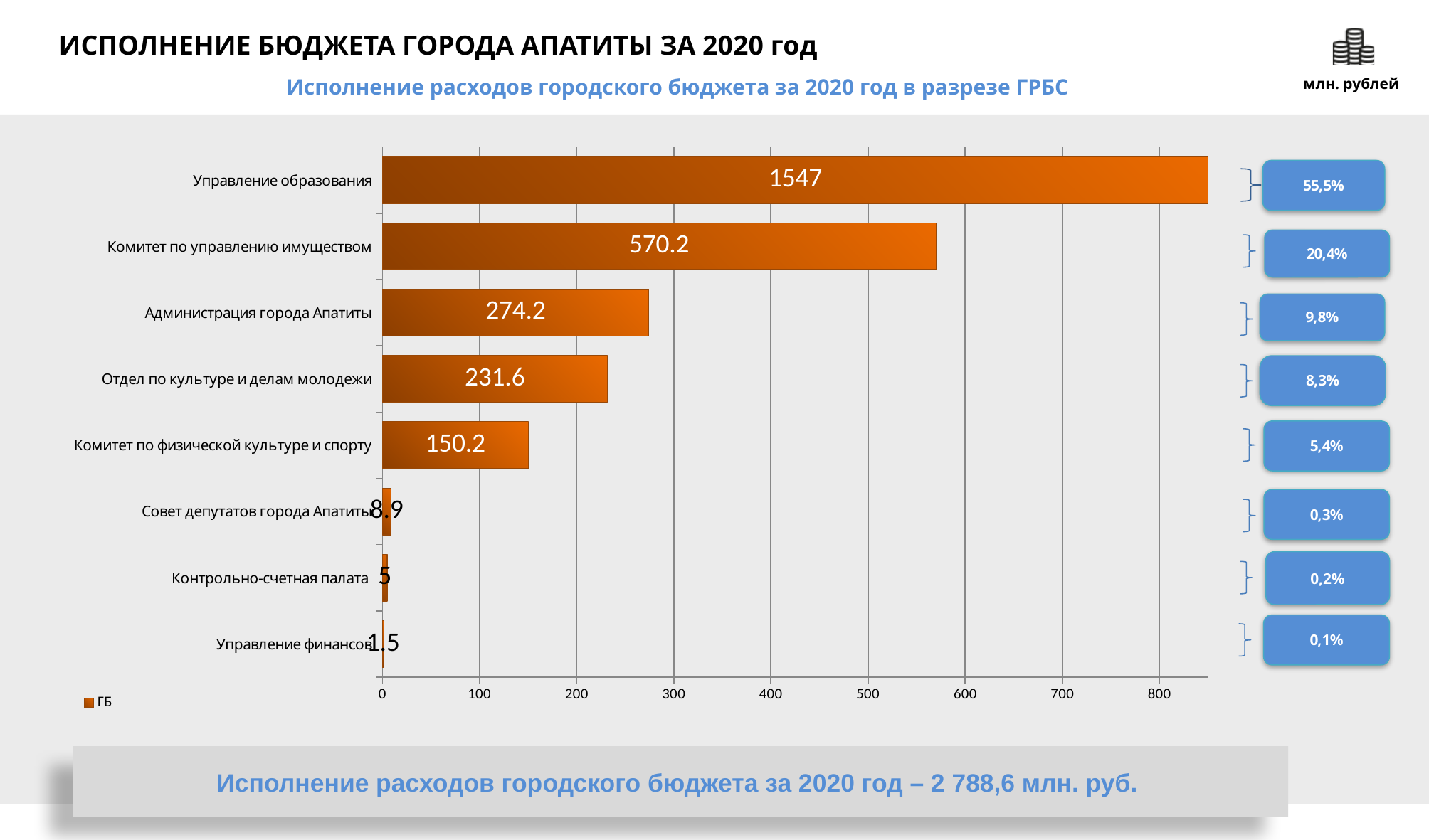
What is the difference between the values for Администрация города Апатиты and Отдел по культуре и делам молодежи? 42.6 How many series does the legend list? 1 What is the name of the series shown in the legend? ГБ Which category has the lowest value? Управление финансов Which is larger, the value for Комитет по физической культуре и спорту or the value for Совет депутатов города Апатиты? Комитет по физической культуре и спорту What is the value for Управление образования? 1547 What is the value for Комитет по управлению имуществом? 570.2 What is the value for Отдел по культуре и делам молодежи? 231.6 How many categories are shown in the chart? 8 What kind of chart is shown on the slide? bar chart Which category has the highest value? Управление образования What is the value for Контрольно-счетная палата? 5